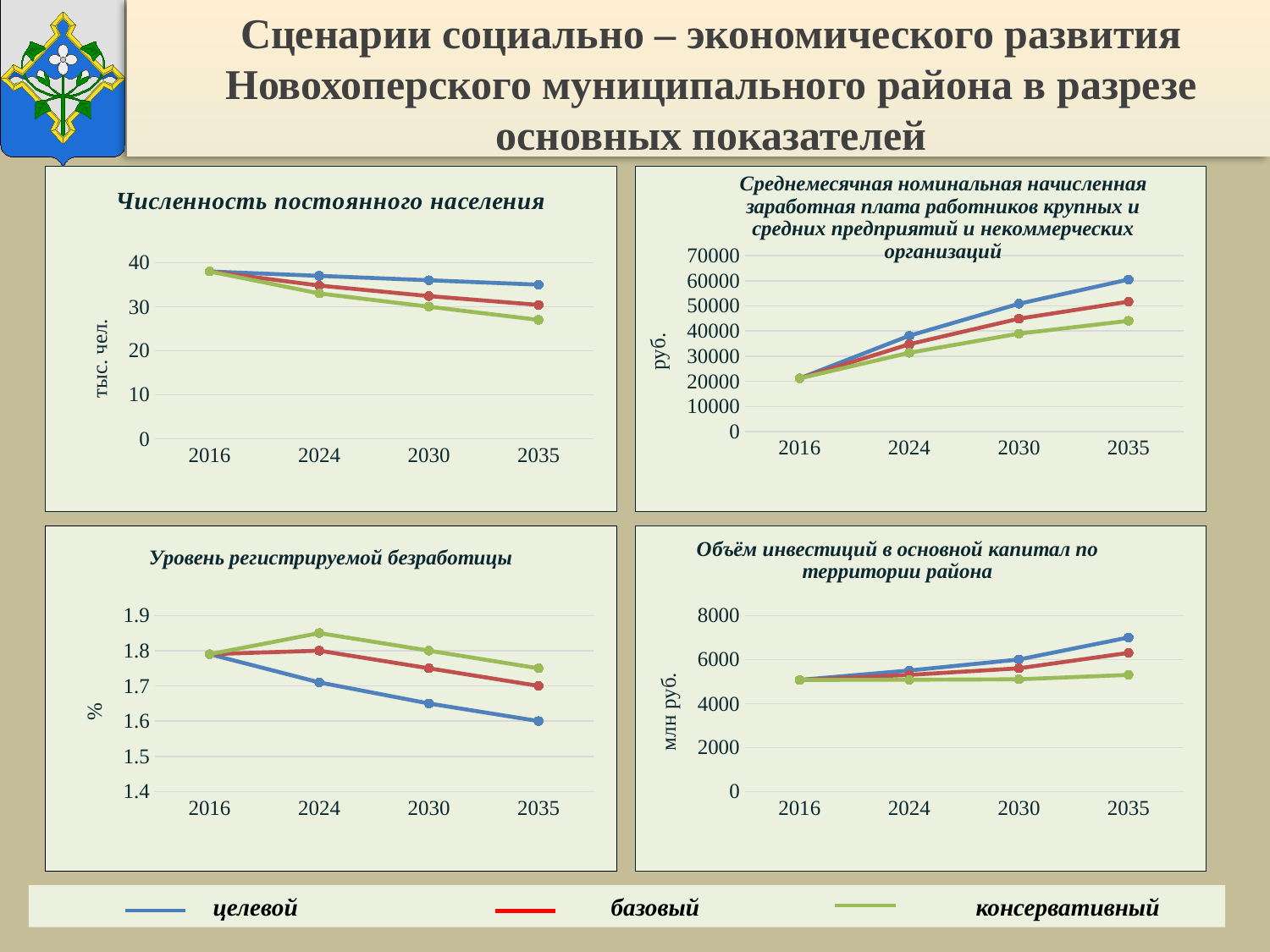
In the "Численность постоянного населения" chart, how many years are shown on the x axis? 4 In the "Численность постоянного населения" chart, do the values rise or fall from 2016 to 2035? fall What unit is shown on the y axis of the "Объём инвестиций в основной капитал по территории района" chart? млн руб. In the "Среднемесячная номинальная начисленная заработная плата" chart, do the values rise or fall from 2016 to 2035? rise In the "Среднемесячная номинальная начисленная заработная плата" chart, is the value for целевой in 2035 greater or less than 50000? greater How many series does the legend at the bottom of the slide list? 3 In the "Уровень регистрируемой безработицы" chart, which is larger in 2035: целевой or консервативный? консервативный In the "Численность постоянного населения" chart, is the value for консервативный in 2035 greater or less than 30? less In the "Объём инвестиций в основной капитал по территории района" chart, which series is highest in 2035? целевой What kind of chart is "Численность постоянного населения"? line chart In the "Численность постоянного населения" chart, which series is lowest in 2035? консервативный In the "Объём инвестиций в основной капитал по территории района" chart, is the value for консервативный in 2035 greater or less than 6000? less